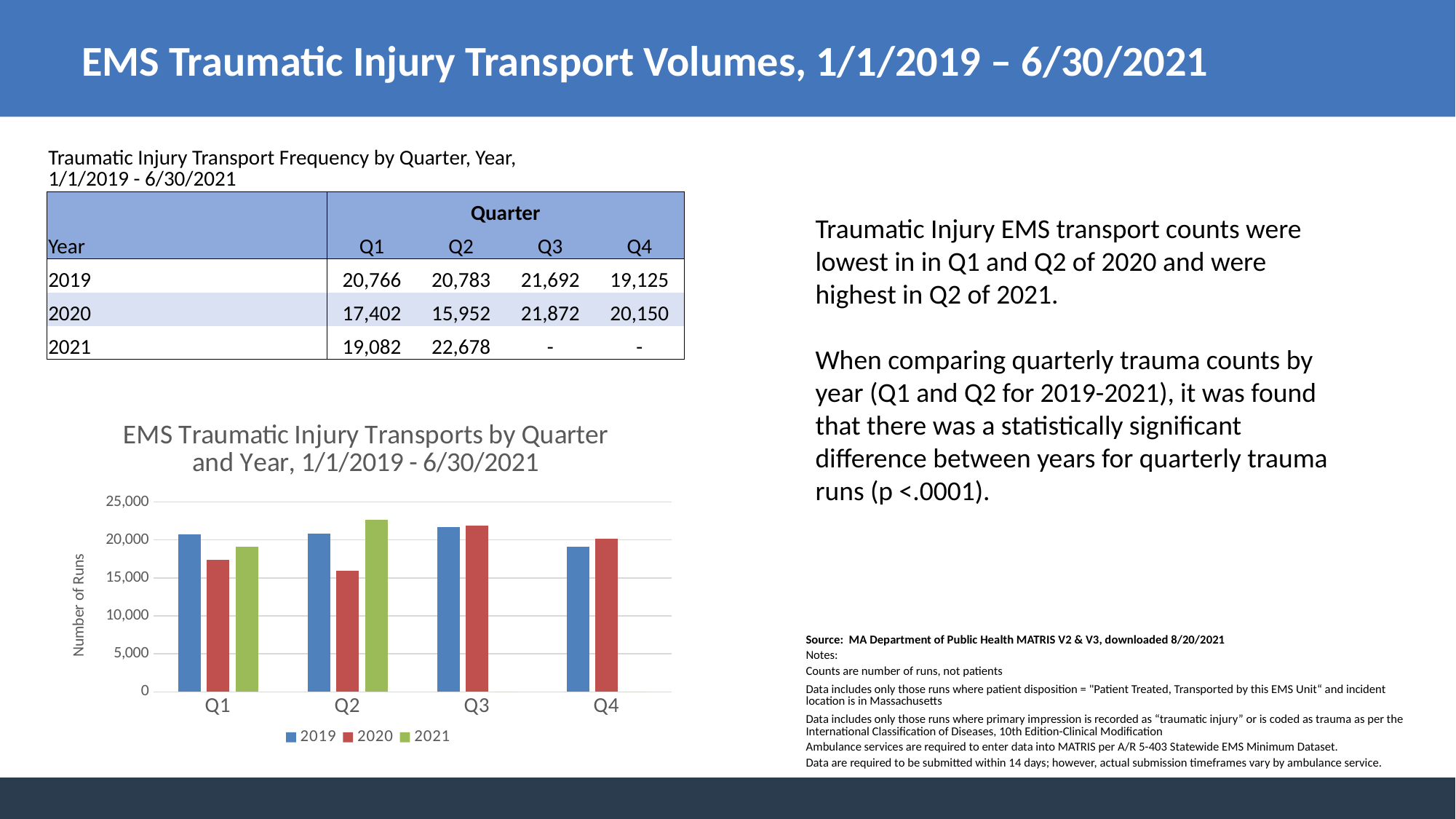
How many quarter categories are shown on the x axis of the chart? 4 What kind of chart is shown on the slide? bar chart What is the y-axis label of the chart? Number of Runs What is the difference between the 2021 and 2020 values in Q2? 6,726 What is the number of runs for 2021 in Q2? 22,678 Is the value for 2020 in Q2 greater or less than 20,000? less What is the number of runs for 2020 in Q2? 15,952 Which year has the lowest number of runs in Q1? 2020 How many series does the chart legend list? 3 What is the title of the chart? EMS Traumatic Injury Transports by Quarter and Year, 1/1/2019 - 6/30/2021 Which year has the highest number of runs in Q2? 2021 What is the number of runs for 2019 in Q3? 21,692